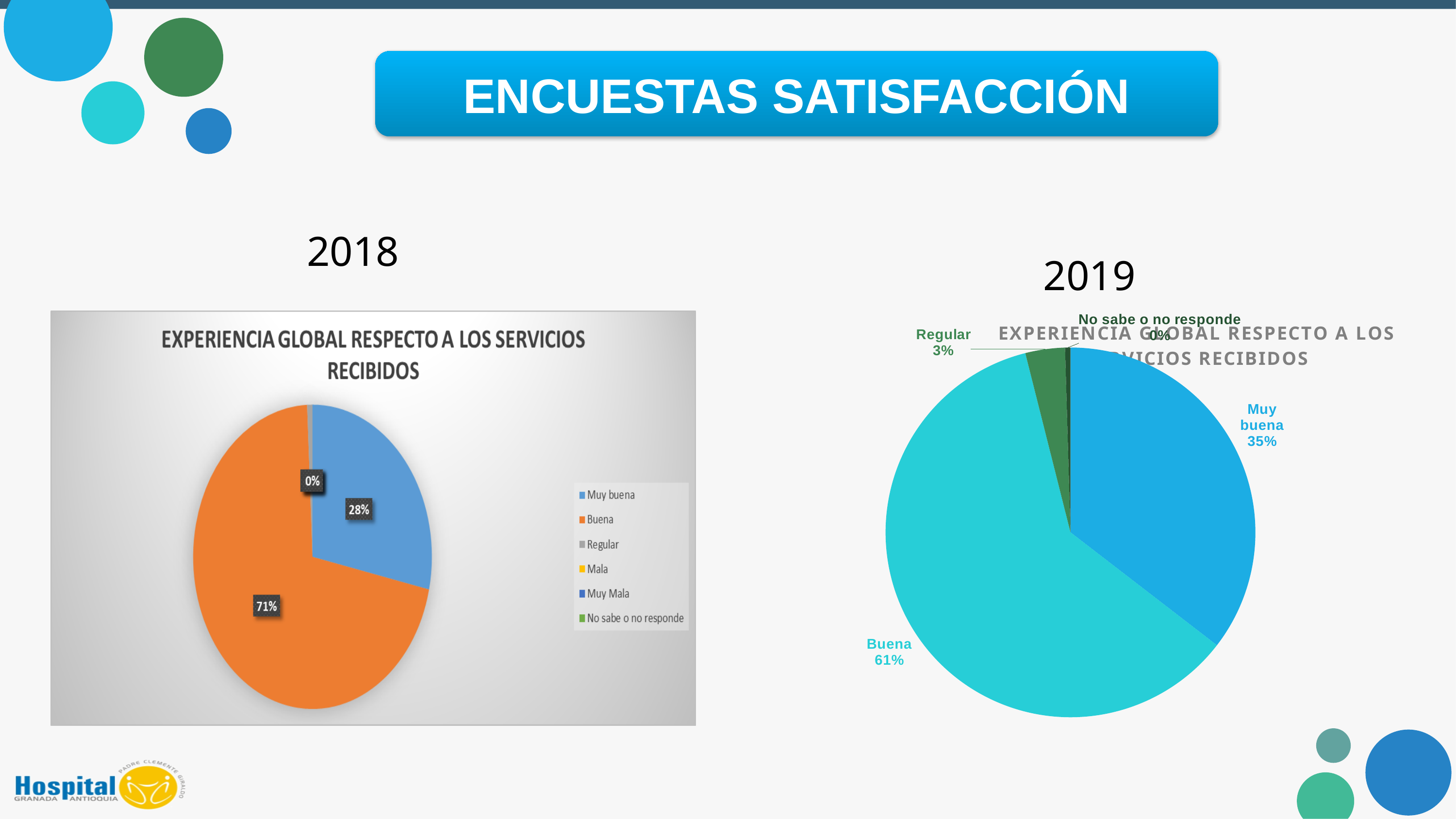
In the 2019 chart, what percentage is shown for Buena? 61% How many entries does the legend of the 2018 chart list? 6 In the 2018 chart, what percentage is shown for Muy buena? 28% Which is larger: Muy buena in the 2018 chart or Muy buena in the 2019 chart? 2019 In the 2018 chart, which category has the largest slice? Buena In the 2019 chart, which labelled category has the largest slice? Buena In the 2019 chart, what percentage is shown for Muy buena? 35% In the 2019 chart, what percentage is shown for No sabe o no responde? 0% In the 2018 chart, what percentage is shown for Buena? 71% In the 2019 chart, what percentage is shown for Regular? 3% In the 2019 chart, what is the difference in percentage points between Buena and Muy buena? 26 What type of chart is used for the 2019 data? Pie chart